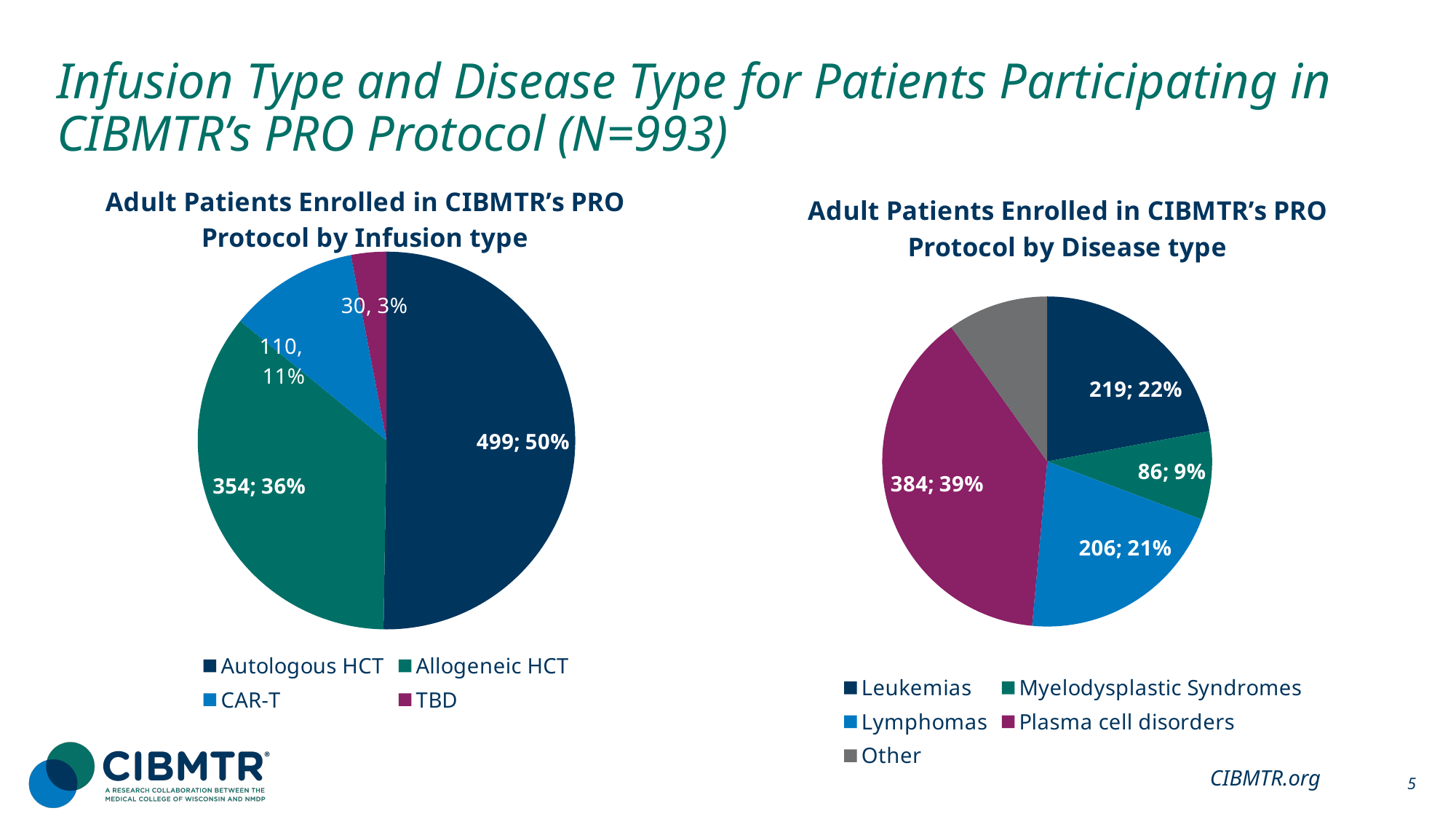
In the 'Adult Patients Enrolled in CIBMTR's PRO Protocol by Disease type' chart, how many disease categories does the legend list? 5 In the 'Adult Patients Enrolled in CIBMTR's PRO Protocol by Infusion type' chart, how many patients received Autologous HCT? 499 In the 'Adult Patients Enrolled in CIBMTR's PRO Protocol by Disease type' chart, what share of patients have Leukemias? 22% In the 'Adult Patients Enrolled in CIBMTR's PRO Protocol by Disease type' chart, which disease type has the largest slice? Plasma cell disorders In the 'Adult Patients Enrolled in CIBMTR's PRO Protocol by Disease type' chart, which has more patients, Lymphomas or Myelodysplastic Syndromes? Lymphomas In the 'Adult Patients Enrolled in CIBMTR's PRO Protocol by Infusion type' chart, what share of patients received Allogeneic HCT? 36% What type of chart is used for the 'Adult Patients Enrolled in CIBMTR's PRO Protocol by Disease type' chart? Pie chart In the 'Adult Patients Enrolled in CIBMTR's PRO Protocol by Infusion type' chart, what is the difference in patient count between Autologous HCT and Allogeneic HCT? 145 In the 'Adult Patients Enrolled in CIBMTR's PRO Protocol by Infusion type' chart, how many patients received CAR-T? 110 In the 'Adult Patients Enrolled in CIBMTR's PRO Protocol by Infusion type' chart, how many infusion types are shown? 4 In the 'Adult Patients Enrolled in CIBMTR's PRO Protocol by Infusion type' chart, which infusion type has the smallest slice? TBD In the 'Adult Patients Enrolled in CIBMTR's PRO Protocol by Disease type' chart, how many patients have Plasma cell disorders? 384